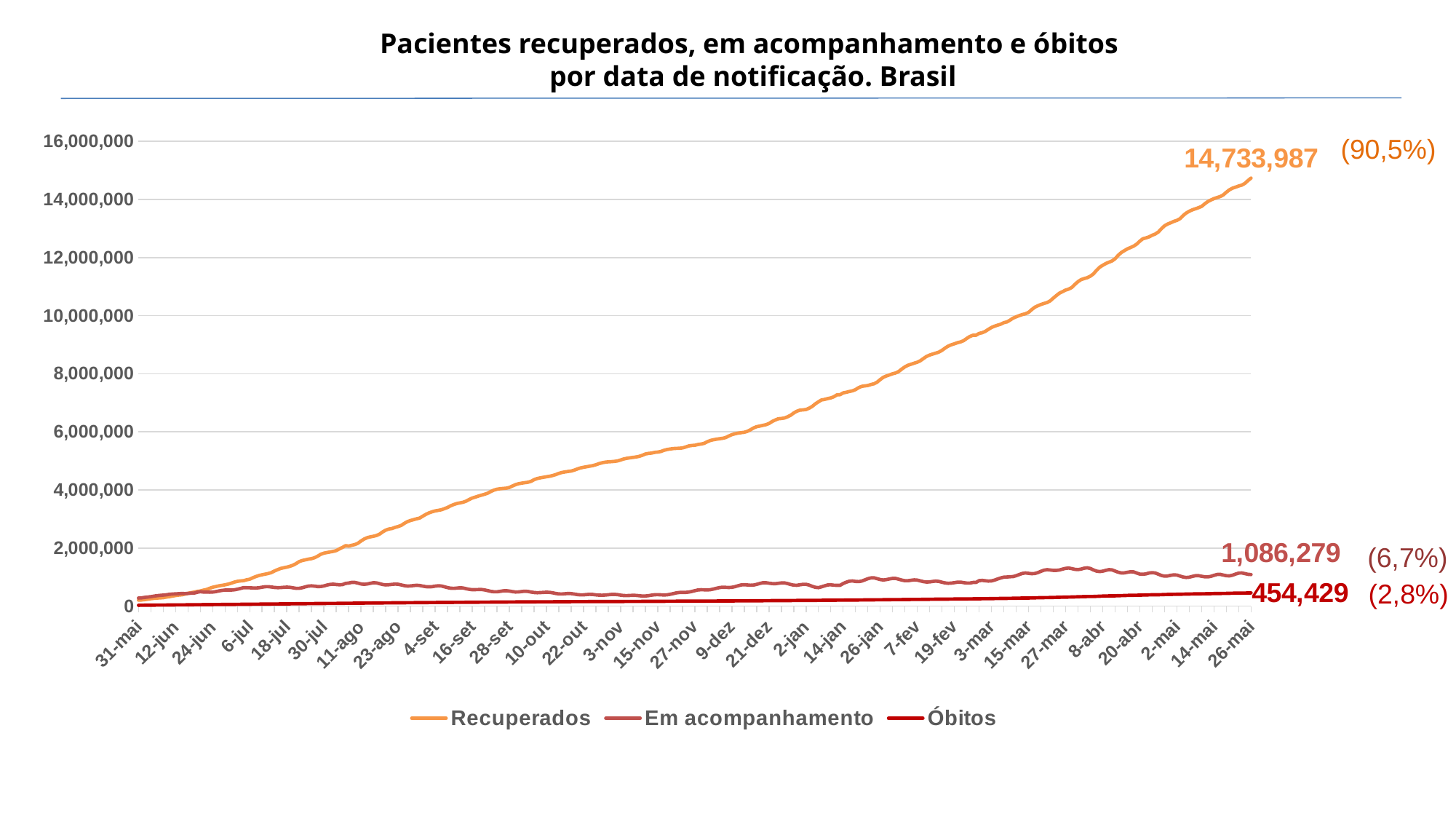
Is the value for Recuperados at 2-jan greater or less than 6,000,000? greater At the end of the chart, which is larger: Em acompanhamento or Óbitos? Em acompanhamento What percentage is shown next to the Óbitos final value? 2,8% How many series does the legend list? 3 Which series has the lowest value at the end of the chart? Óbitos What percentage is shown next to the Recuperados final value? 90,5% Which series has the highest value at the end of the chart? Recuperados What is the difference between the final values of Em acompanhamento and Óbitos? 631,850 What is the final value shown for the Em acompanhamento series? 1,086,279 What kind of chart is shown on the slide? Line chart What is the final value shown for the Óbitos series? 454,429 What is the final value shown for the Recuperados series? 14,733,987